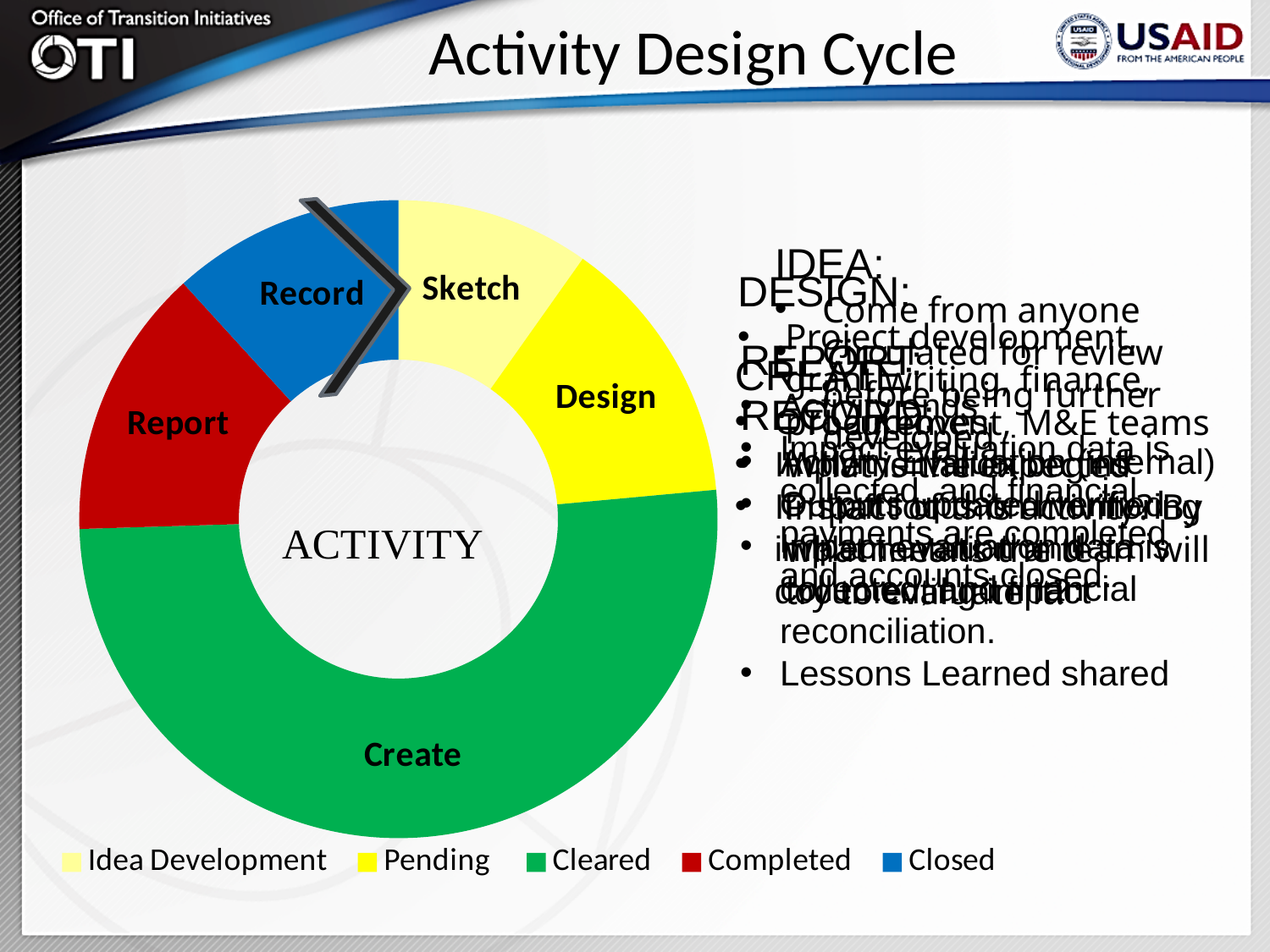
What text appears in the centre of the doughnut chart? ACTIVITY Which is larger in the doughnut chart, the Create segment or the Report segment? Create How many segments does the doughnut chart have? 5 Which is larger in the doughnut chart, the Create segment or the Design segment? Create What legend entry corresponds to the green segment labelled Create? Cleared What kind of chart is shown on the slide? Doughnut chart Which is larger in the doughnut chart, the Create segment or the Sketch segment? Create How many entries does the chart legend list? 5 Which segment of the doughnut chart is the largest? Create